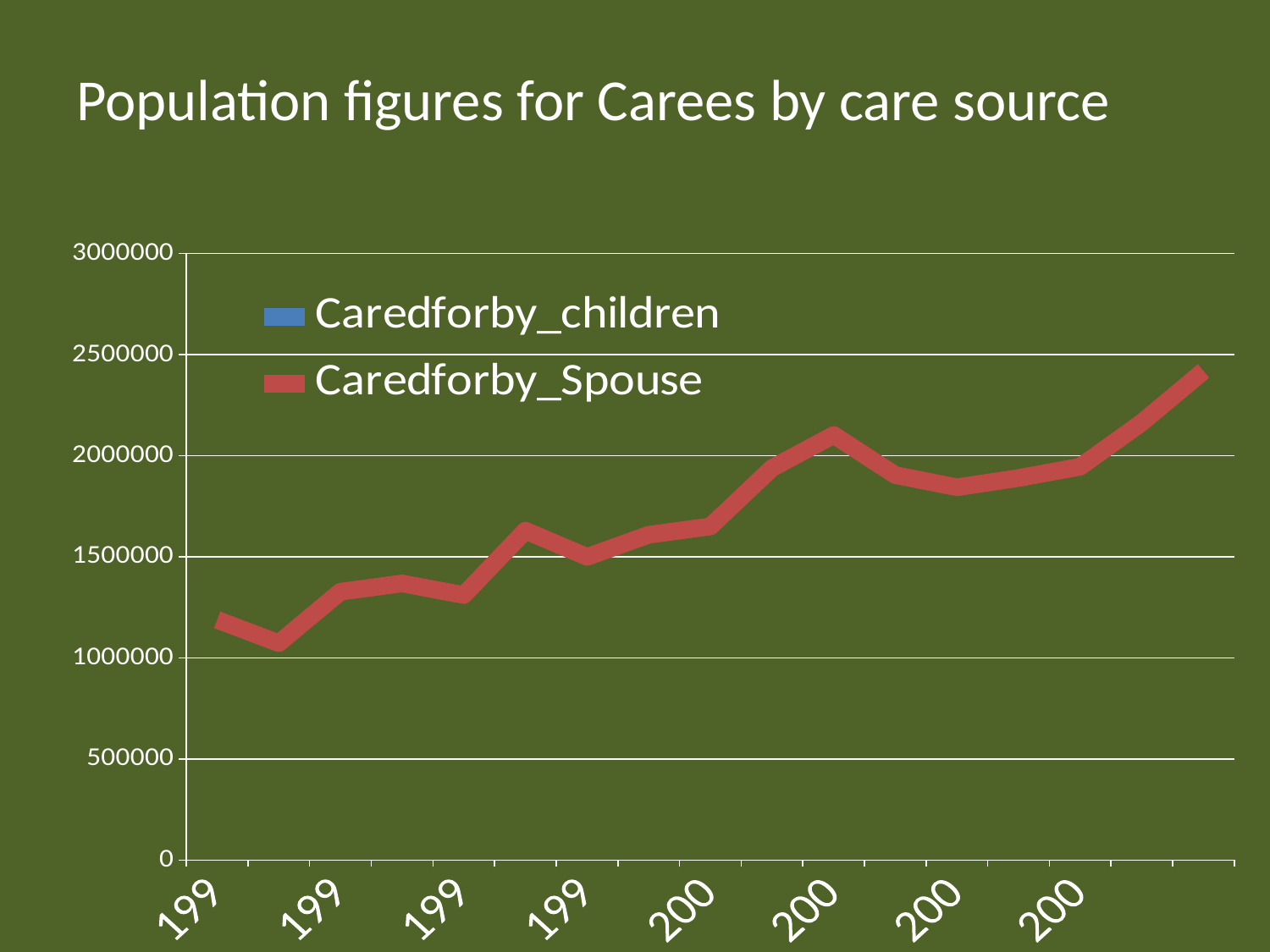
Is the first (leftmost) value of the Caredforby_Spouse line greater or less than 1500000? less What is the title of the chart? Population figures for Carees by care source What kind of chart is shown on the slide? Line chart Is the lowest value of the Caredforby_Spouse line greater or less than 1500000? less How many series does the legend list? 2 Is the highest value reached by the Caredforby_Spouse line greater or less than 2500000? less Overall, does the Caredforby_Spouse line rise or fall from left to right along the x axis? Rise Which series is shown in red in the legend? Caredforby_Spouse Which is larger for the Caredforby_Spouse line: the leftmost value or the rightmost value? The rightmost value